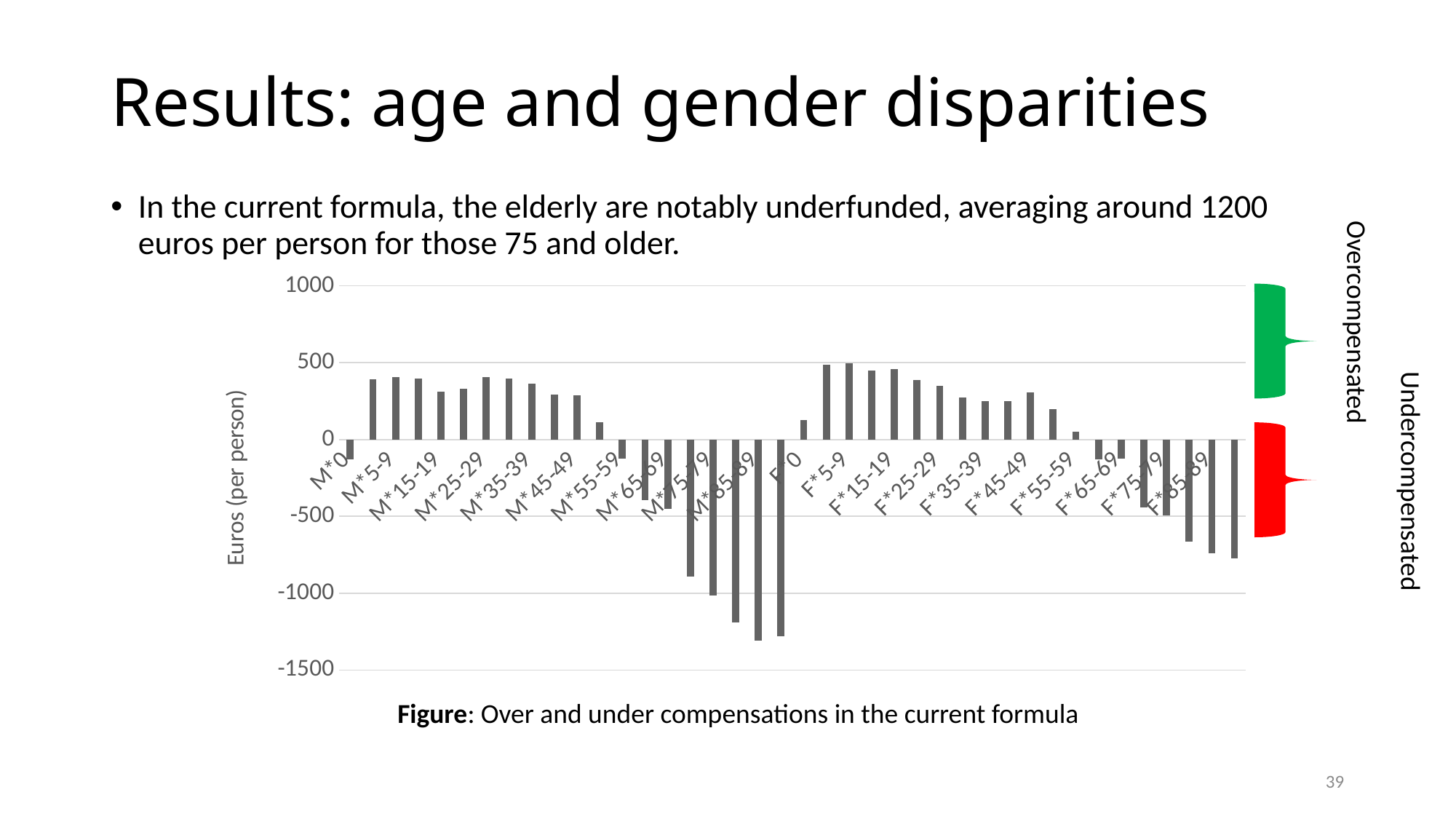
Which has the lower value, M*85-89 or F*85-89? M*85-89 What kind of chart is shown on the slide? bar chart Is the value for M*65-69 greater or less than 0? less Do the values for the female groups rise or fall from F*5-9 to F*85-89? fall Is the value for M*75-79 greater or less than -500? less Which has the larger value, M*5-9 or M*55-59? M*5-9 Is the value for F*35-39 greater or less than 500? less What is the title of the vertical axis of the chart? Euros (per person) What does the green bracket to the right of the chart indicate? Overcompensated